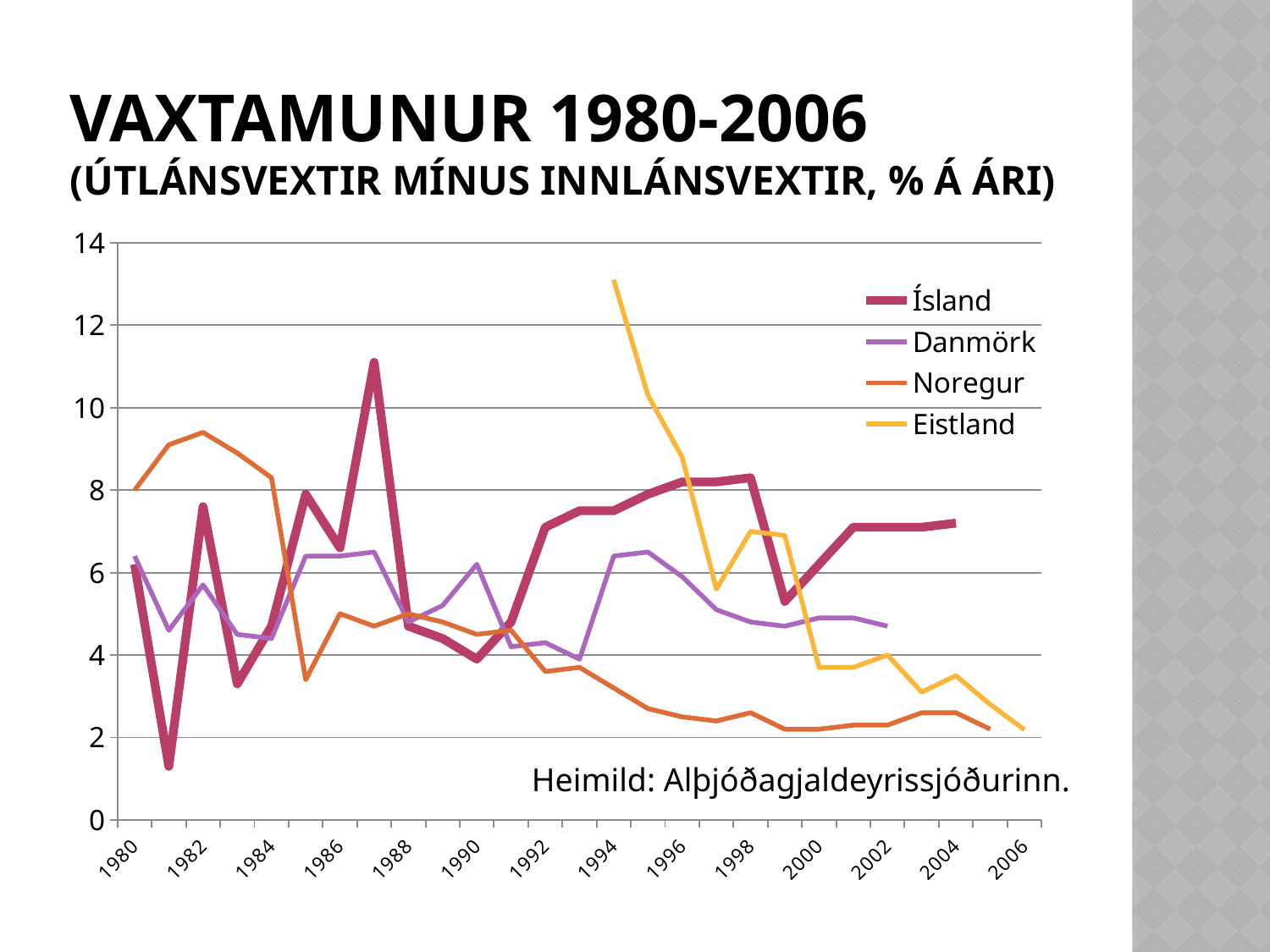
Does the Eistland line rise or fall from 1994 to 2006? fall How many series does the legend list? 4 Is the value for Ísland in 1981 greater or less than 2? less Is the value for Noregur in 2005 greater or less than 4? less In 2000, which is larger, the value for Ísland or the value for Noregur? Ísland Is the value for Ísland in 1987 greater or less than 10? greater Which series reaches the highest value anywhere on the chart? Eistland Which series is drawn with the thick dark red line? Ísland In 1982, which is larger, the value for Noregur or the value for Danmörk? Noregur What is the first year labelled on the x axis? 1980 What kind of chart is shown on the slide? line chart